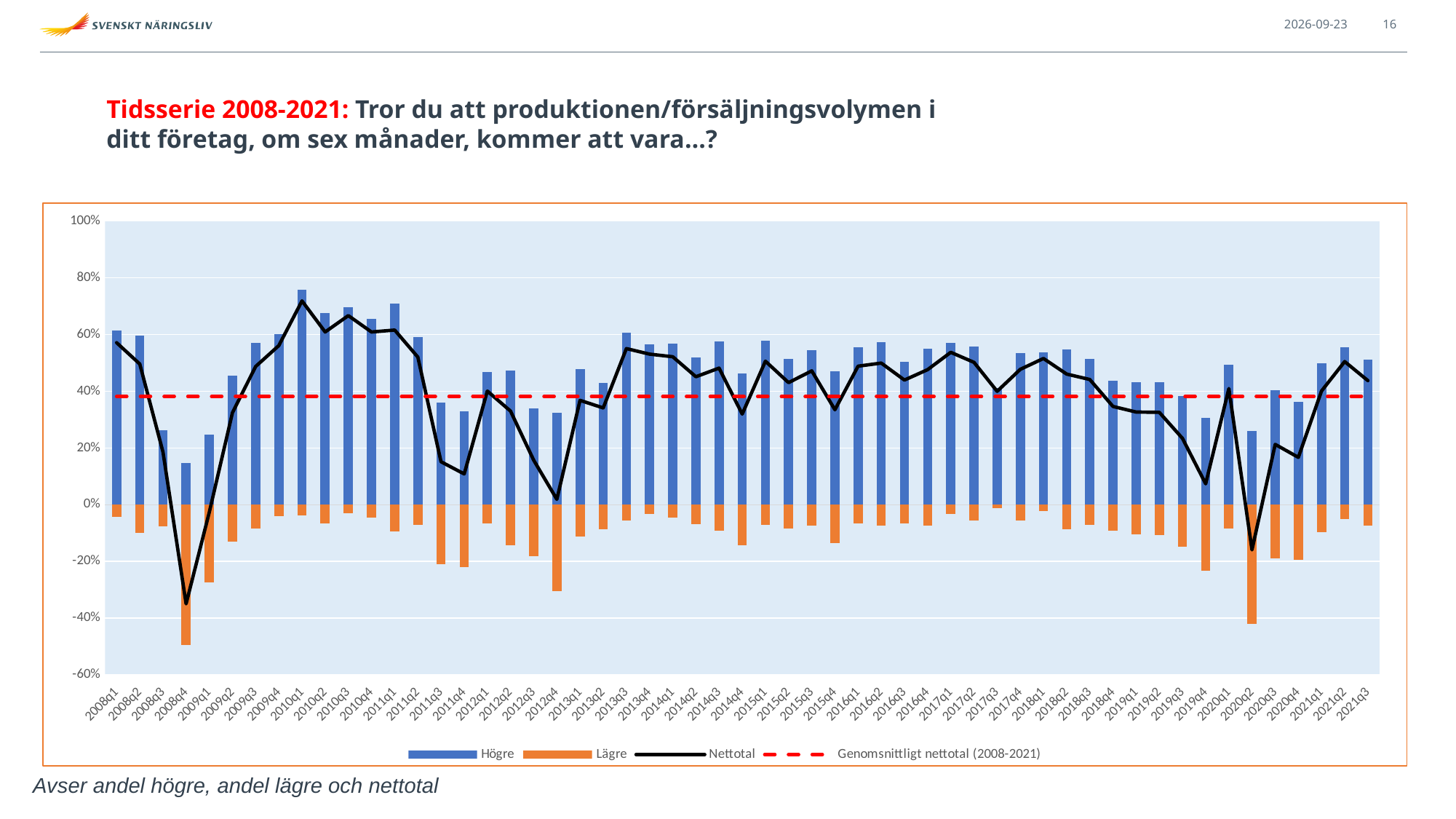
In which quarter does the Nettotal line reach its lowest point? 2008q4 Does the Nettotal line rise or fall from 2008q1 to 2008q4? fall Which quarter has the lowest value for the Högre series? 2008q4 Is the Högre value for 2008q4 greater or less than 20%? less Which is larger, the Nettotal value for 2008q4 or for 2020q2? 2020q2 Is the Nettotal value for 2020q2 greater or less than 0%? less Which quarter has the highest value for the Högre series? 2010q1 In which quarter does the Nettotal line reach its highest point? 2010q1 How many series does the legend list? 4 What does the red dashed line represent according to the legend? Genomsnittligt nettotal (2008-2021) Is the Lägre value for 2008q4 greater or less than -40%? less